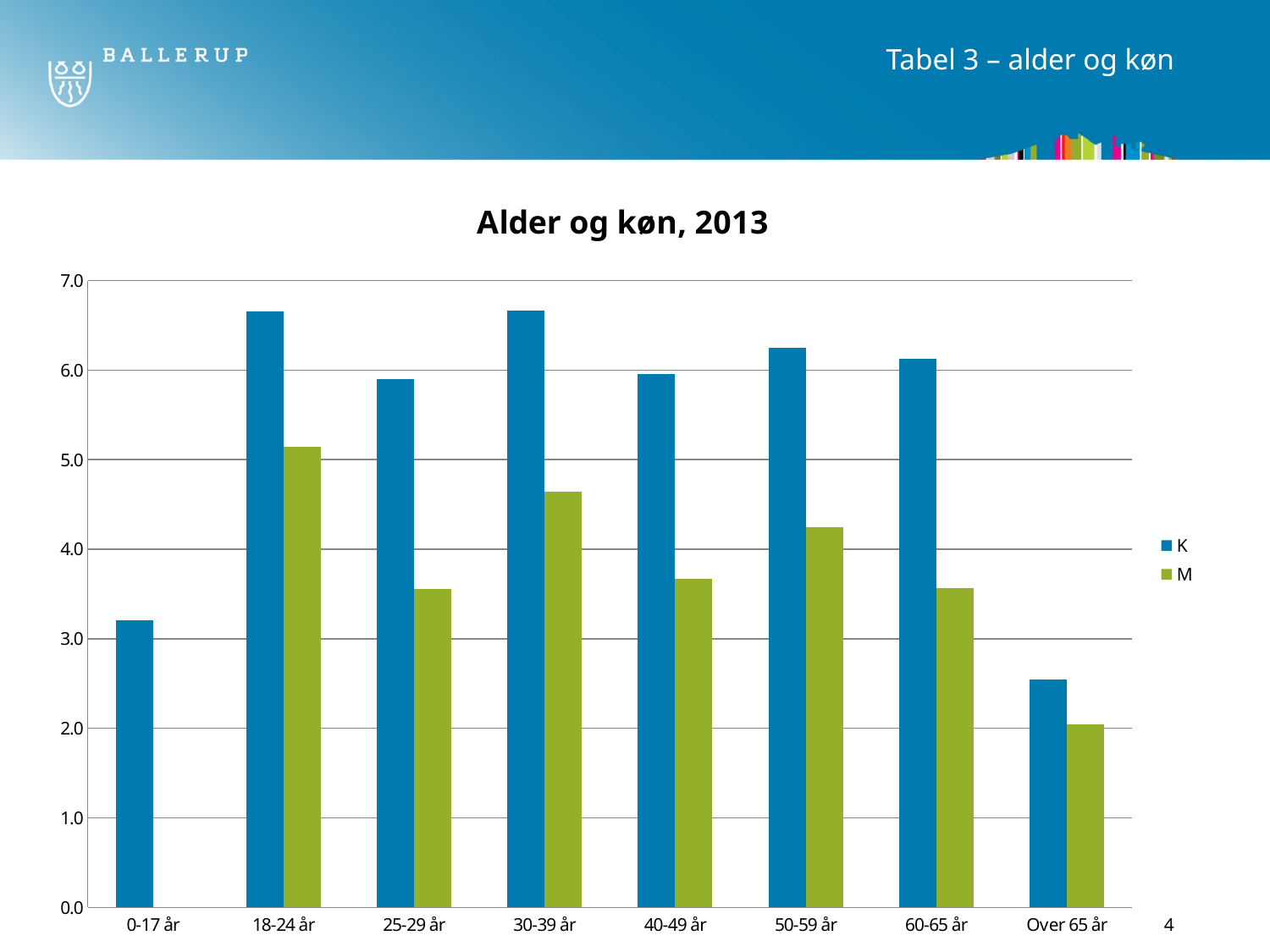
Which age category has the lowest value for K? Over 65 år What kind of chart is shown on the slide? bar chart Is the value for K in 0-17 år greater or less than 4.0? less How many age categories are shown on the x axis? 8 Which is larger: the M value for 50-59 år or the M value for 40-49 år? 50-59 år Is the value for M in 25-29 år greater or less than 4.0? less How many series does the legend list? 2 Is the value for M in 30-39 år greater or less than 4.0? greater For 18-24 år, which series has the larger value, K or M? K Which age category has the highest value for M? 18-24 år What is the title of the chart? Alder og køn, 2013